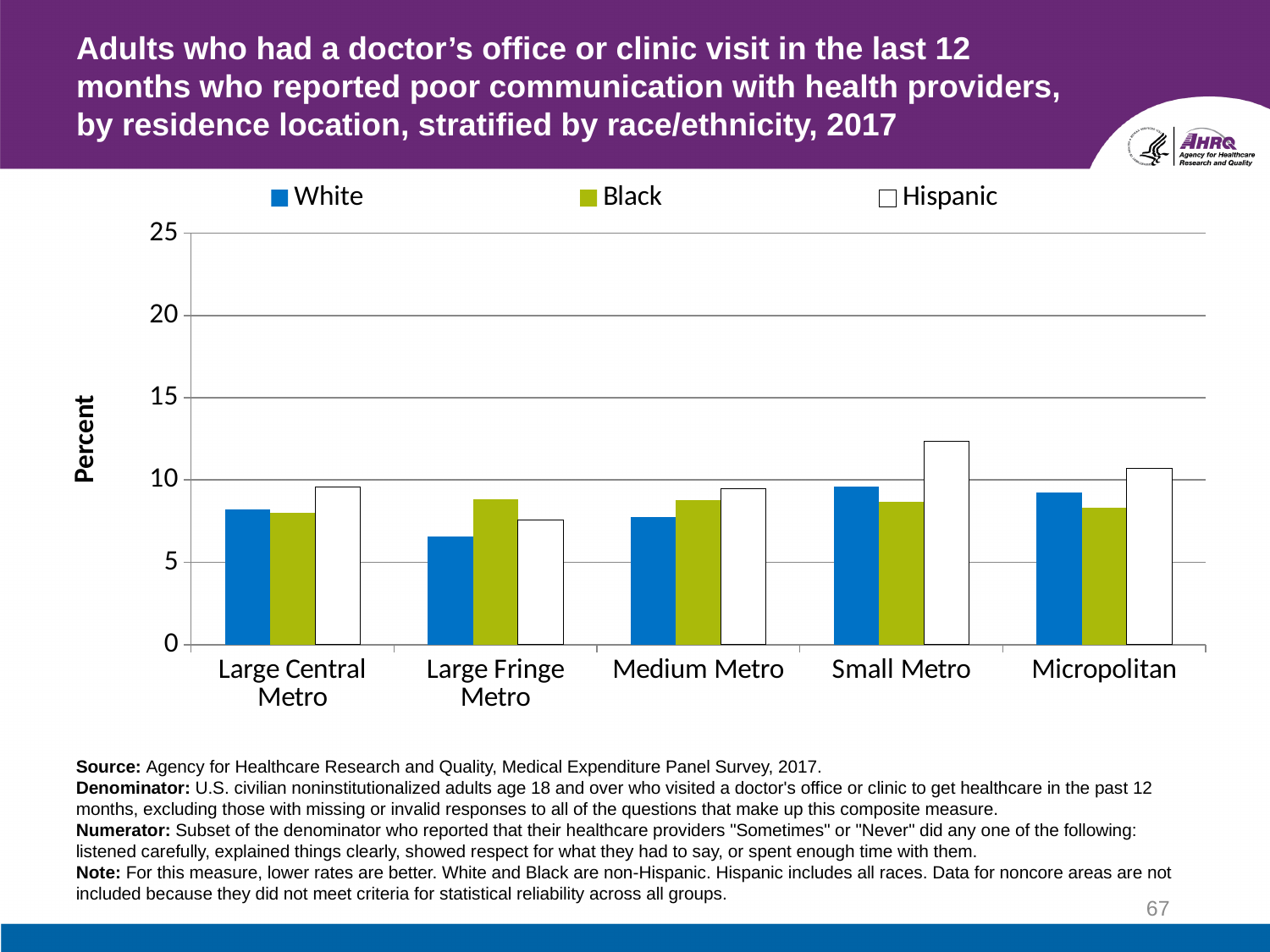
In Large Fringe Metro, which is larger, the value for White or the value for Black? Black Is the value for Hispanic in Small Metro greater or less than 10? greater Which residence location has the highest value for Hispanic? Small Metro Which residence location has the lowest value for White? Large Fringe Metro Which residence location has the lowest value for Hispanic? Large Fringe Metro Is the value for Hispanic in Micropolitan greater or less than 15? less How many residence location categories are shown on the x axis? 5 What kind of chart is shown on the slide? Bar chart What is the label on the y axis? Percent Is the value for White in Large Fringe Metro greater or less than 10? less How many series does the legend list? 3 In Small Metro, which is larger, the value for Hispanic or the value for Black? Hispanic